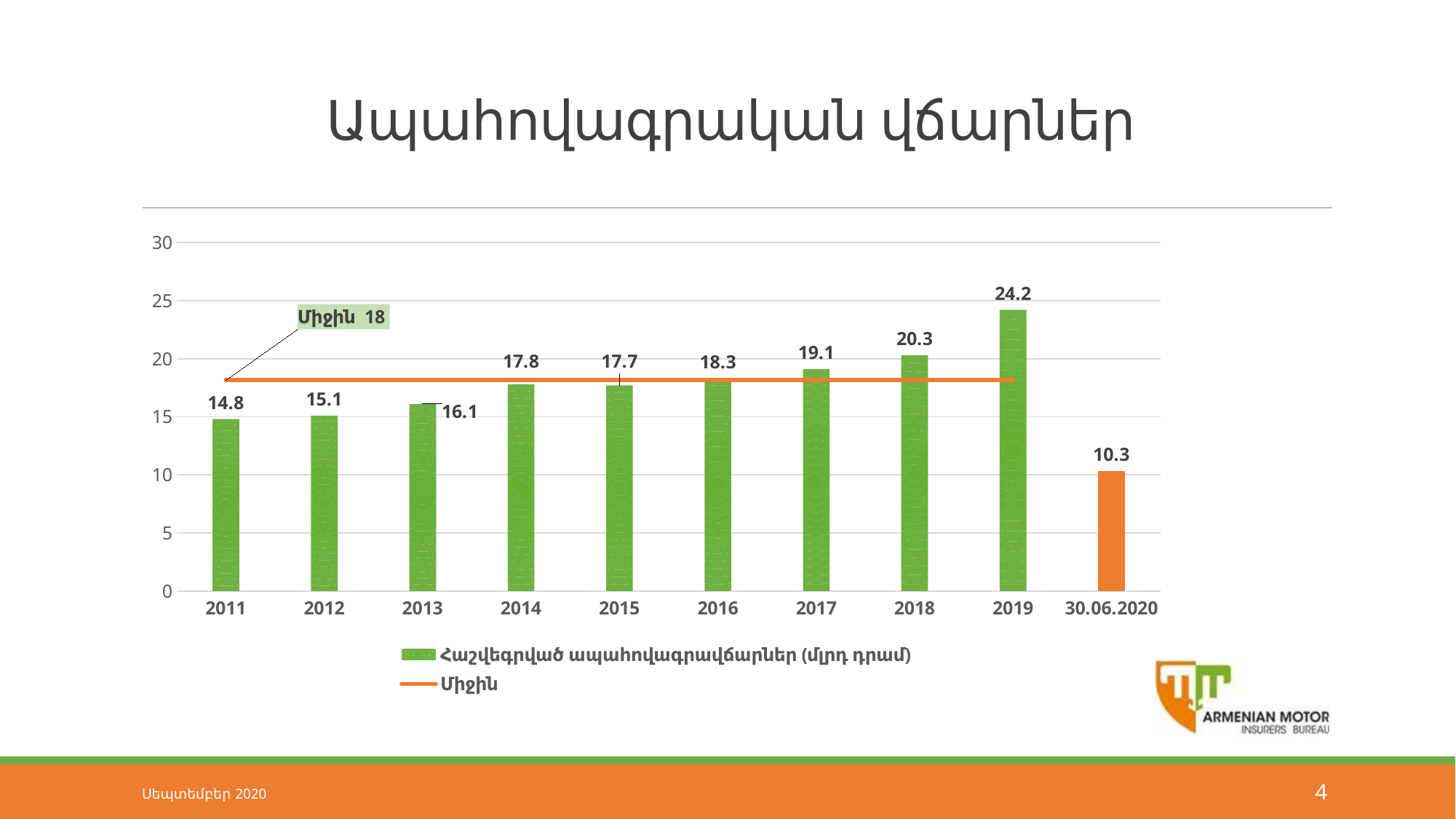
Which category has the lowest value? 30.06.2020 What is the value for 2011? 14.8 How many bars are plotted in the chart? 10 What is the value for 30.06.2020? 10.3 What is the value for 2019? 24.2 What is the difference between the values for 2019 and 2018? 3.9 What kind of chart is shown on the slide? combination bar and line chart What value does the average (Միջին) line represent, as labelled on the chart? 18 How many series does the legend list? 2 Which is larger, the value for 2014 or the value for 2015? 2014 Which category has the highest value? 2019 Is the value for 2017 greater or less than 20? less